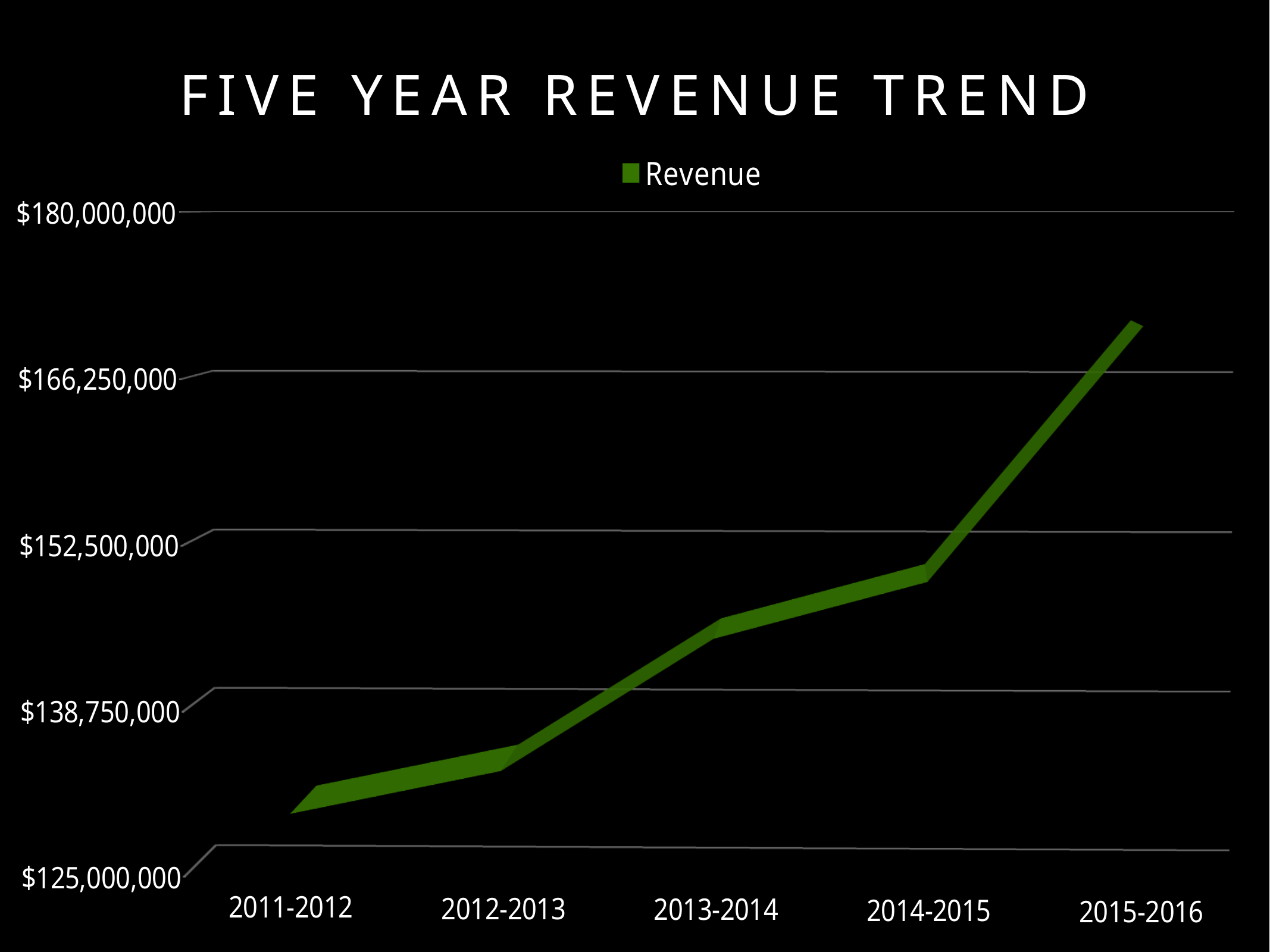
Which period has the highest revenue? 2015-2016 How many series does the legend list? 1 What is the title of the chart? FIVE YEAR REVENUE TREND Is the revenue for 2011-2012 greater or less than $138,750,000? less Is the revenue for 2013-2014 greater or less than $138,750,000? greater What is the name of the series shown in the legend? Revenue Which period has the lowest revenue? 2011-2012 Which period has higher revenue, 2012-2013 or 2014-2015? 2014-2015 How many periods are plotted along the x axis? 5 What kind of chart is shown on the slide? line chart Is the revenue for 2015-2016 greater or less than $166,250,000? greater Do revenue values rise or fall from 2011-2012 to 2015-2016? rise